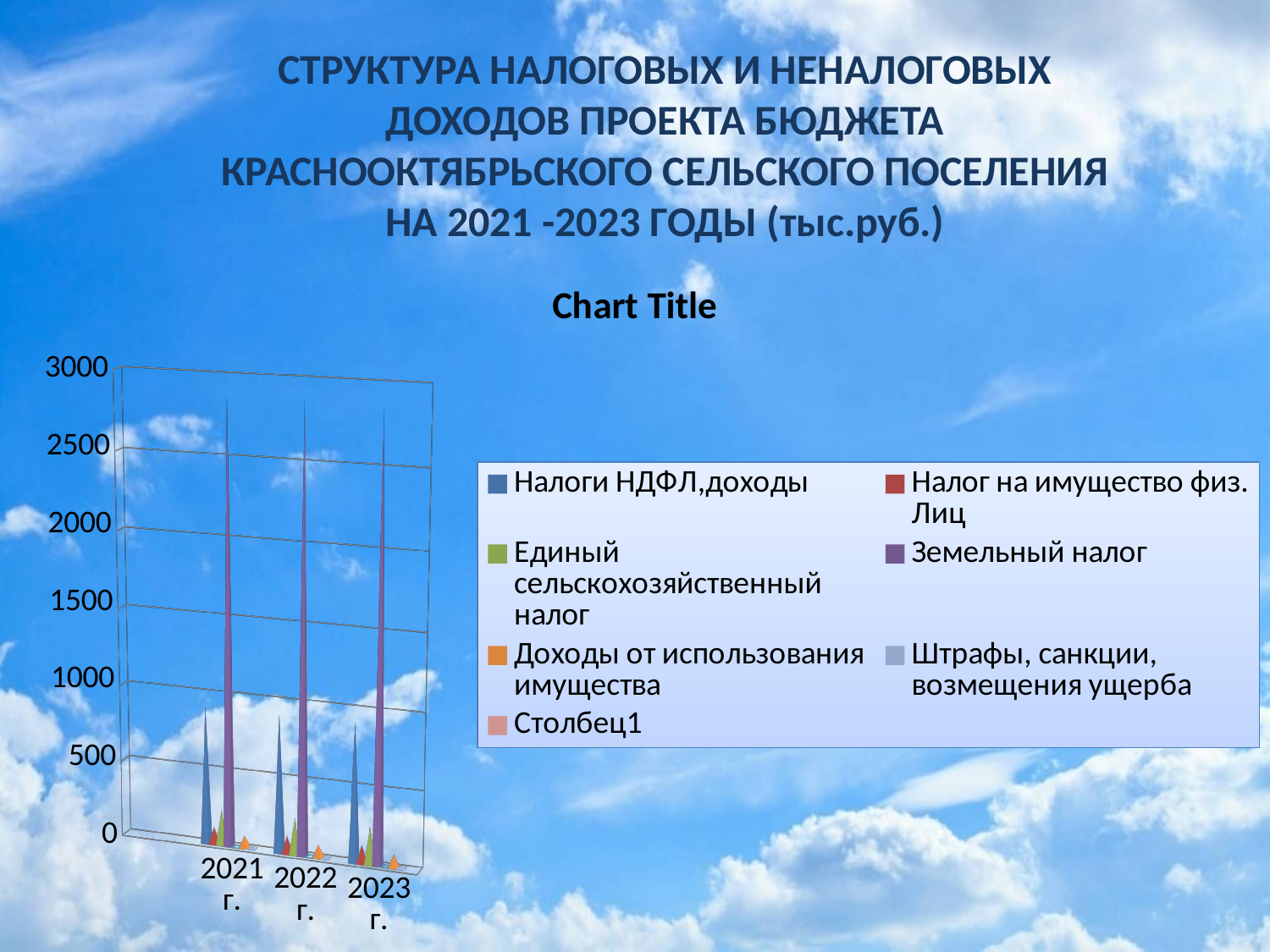
Is the value for Доходы от использования имущества in 2022 г. greater or less than 500? less How many series does the chart legend list? 7 Is the value for Налоги НДФЛ,доходы in 2021 г. greater or less than 1500? less What kind of chart is shown on the slide? bar chart Is the value for Земельный налог in 2023 г. greater or less than 1500? greater What is the title printed above the chart? Chart Title Which series has the highest value in 2023 г.? Земельный налог How many year categories are shown on the x axis of the chart? 3 In 2022 г., which is larger: Земельный налог or Налоги НДФЛ,доходы? Земельный налог What is the highest value shown on the vertical axis of the chart? 3000 Which series has the highest value in 2021 г.? Земельный налог